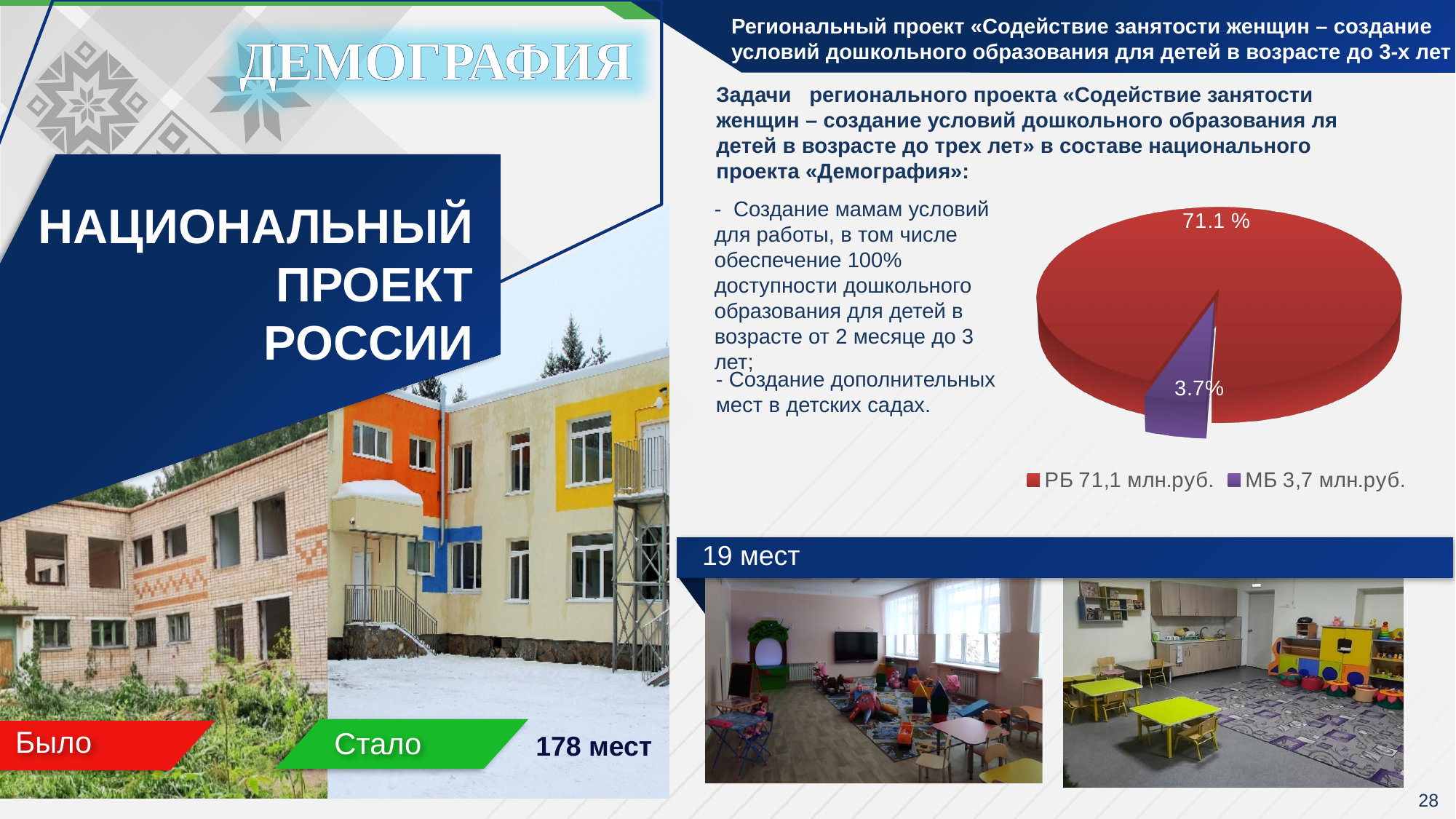
Which legend entry corresponds to the smallest slice of the pie chart? МБ 3,7 млн.руб. What colour is the МБ slice in the pie chart? purple How many entries does the legend of the pie chart list? 2 What data label is shown on the purple slice of the pie chart? 3.7% How many slices does the pie chart have? 2 Which is larger in the pie chart, the РБ slice or the МБ slice? РБ Which legend entry corresponds to the largest slice of the pie chart? РБ 71,1 млн.руб. According to the legend, what amount in млн.руб. is attributed to МБ? 3,7 млн.руб. What kind of chart is shown on the slide? pie chart What colour is the РБ slice in the pie chart? red What data label is shown on the red slice of the pie chart? 71.1 % According to the legend, by how much does the РБ amount exceed the МБ amount? 67,4 млн.руб.